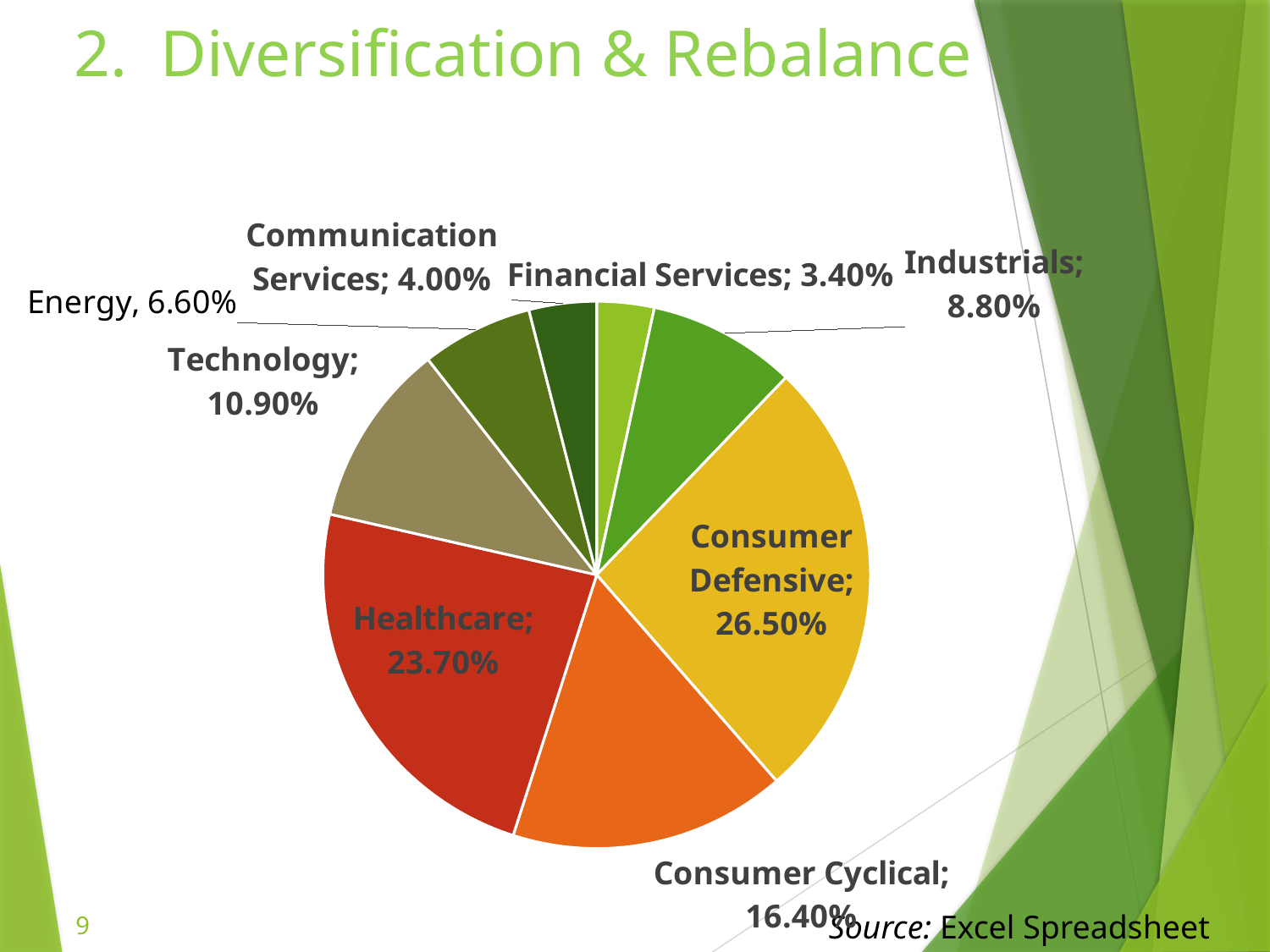
Which sector has the smallest slice of the pie? Financial Services How many slices does the pie chart have? 8 What is the difference between the Consumer Cyclical and Technology values? 5.50% What kind of chart is shown on the slide? Pie chart What is the title of the slide containing the pie chart? 2. Diversification & Rebalance Which sector has the largest slice of the pie? Consumer Defensive What is the difference between the Consumer Defensive and Healthcare values? 2.80% What is the value for Consumer Defensive? 26.50% What is the value for Financial Services? 3.40% What is the value for Healthcare? 23.70% Which is larger, Industrials or Energy? Industrials What is the value for Technology? 10.90%